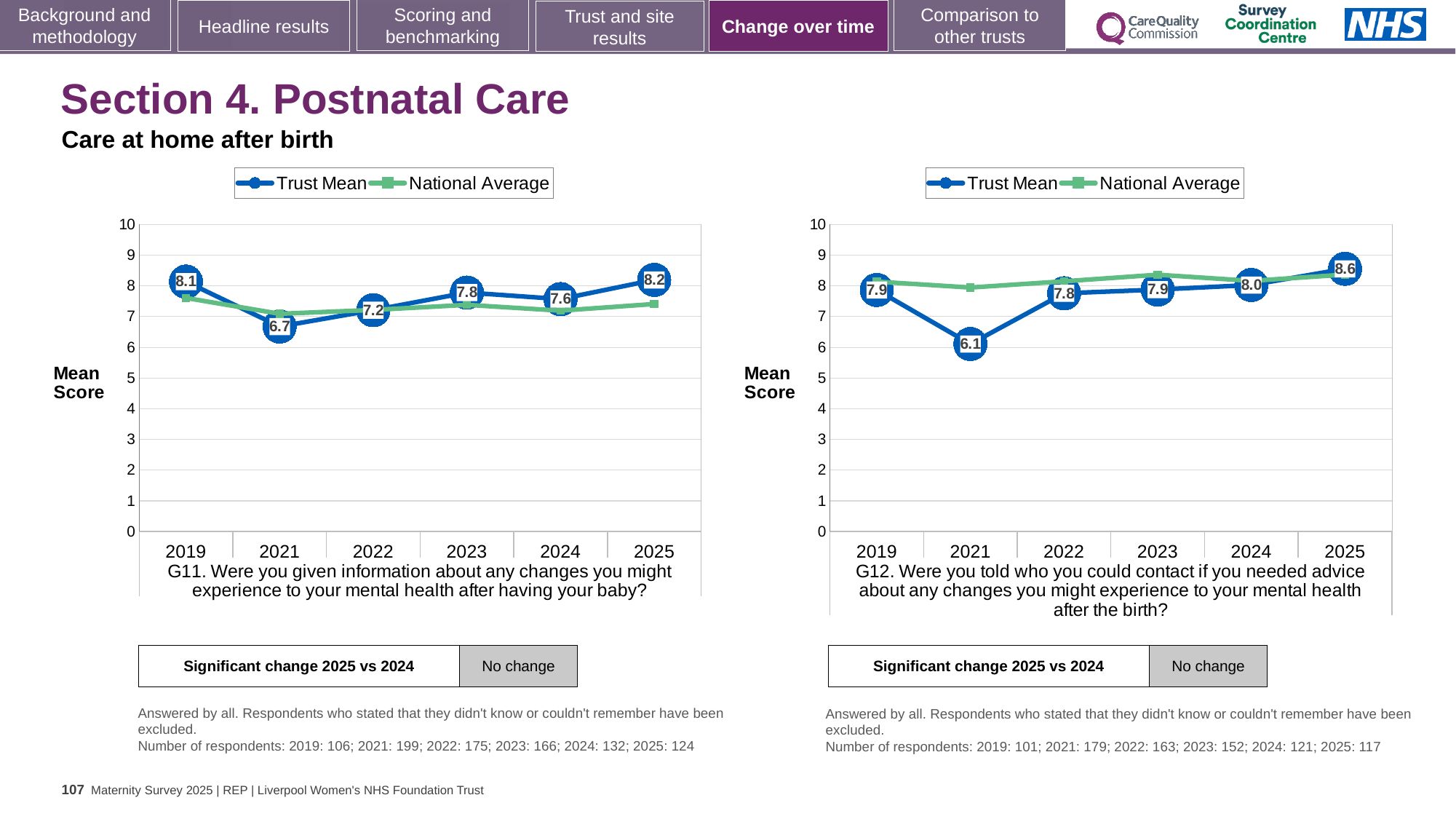
On the G12 chart (right), is the National Average for 2021 greater or less than 7? greater On the G11 chart (left), is the Trust Mean score higher in 2023 or in 2024? 2023 On the G12 chart (right), what is the difference between the Trust Mean scores for 2025 and 2021? 2.5 On the G11 chart (left), which year has the highest Trust Mean score? 2025 On the G11 chart (left), what is the Trust Mean score for 2021? 6.7 On the G11 chart (left), what is the Trust Mean score for 2025? 8.2 How many years are plotted on the G11 chart (left)? 6 What type of chart is the G12 chart (right)? Line chart On the G12 chart (right), which year has the lowest Trust Mean score? 2021 On the G11 chart (left), what is the difference between the Trust Mean scores for 2019 and 2021? 1.4 On the G12 chart (right), what is the Trust Mean score for 2024? 8.0 On the G12 chart (right), what is the Trust Mean score for 2021? 6.1